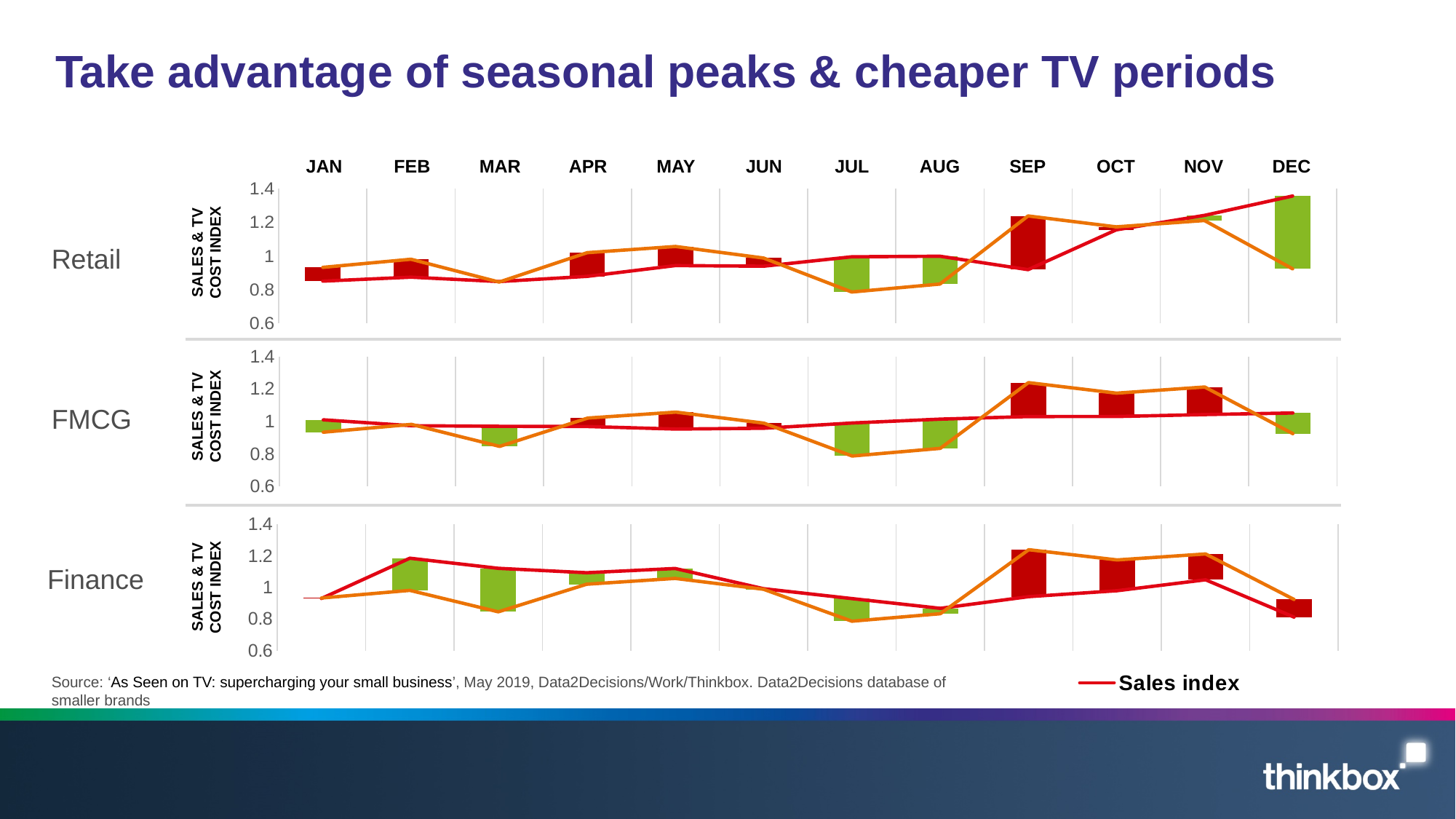
In the Retail chart, does the Sales index rise or fall from SEP to DEC? rise How many charts are shown on the slide? 3 What is the title of the slide containing the three charts? Take advantage of seasonal peaks & cheaper TV periods How many months are plotted along the x axis of the Retail chart? 12 In the Finance chart, does the Sales index rise or fall from MAY to AUG? fall In the Finance chart, is the Sales index for FEB greater or less than 1? greater What series does the legend at the bottom of the slide list? Sales index In the Retail chart, which month has the highest Sales index? DEC In the Retail chart, is the Sales index for JAN greater or less than 1? less In the Retail chart, is the Sales index for DEC greater or less than 1.2? greater In the Finance chart, which month has the highest Sales index? FEB